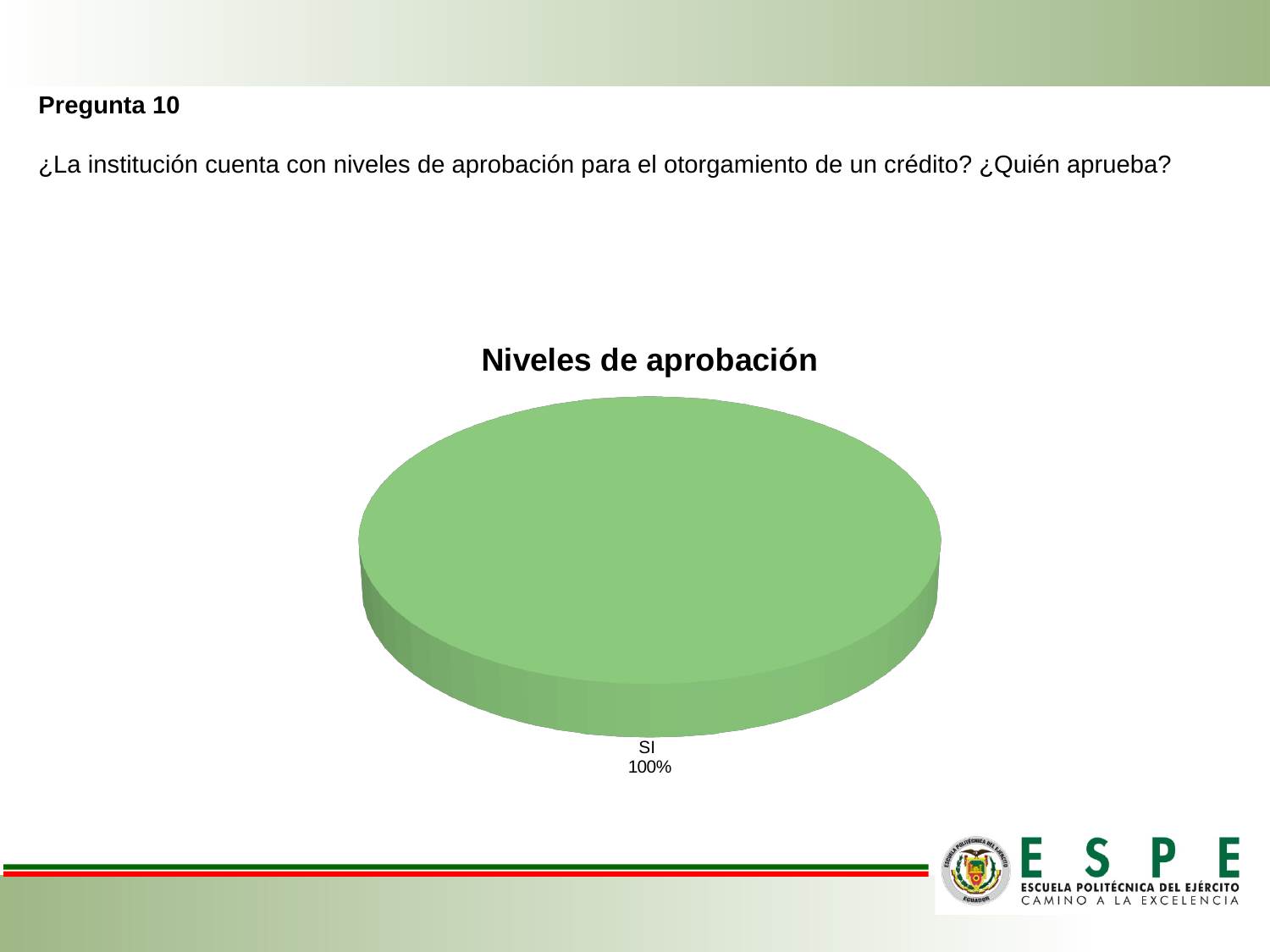
How many slices does the pie chart have? 1 What kind of chart is shown on the slide? pie chart What is the title of the chart? Niveles de aprobación Which category is the largest in the pie chart? SI Is the value for SI greater or less than 50%? greater What is the value shown for the SI category? 100% What share of the pie does the SI slice represent? 100% What colour is the SI slice of the pie chart? green